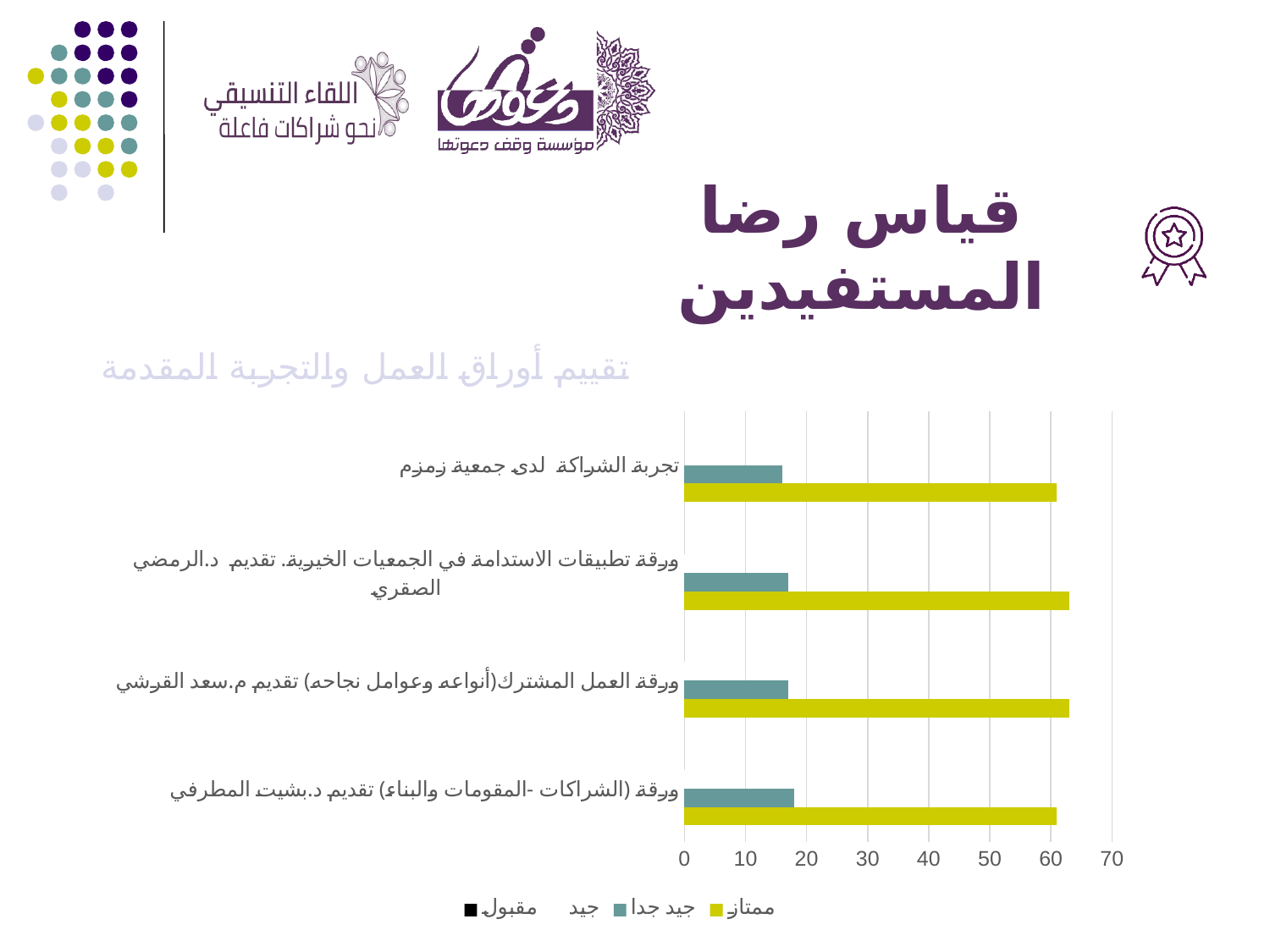
For ورقة (الشراكات - المقومات والبناء) تقديم د.بشيت المطرفي, which is larger: the ممتاز value or the جيد جدا value? ممتاز Is the ممتاز value for ورقة تطبيقات الاستدامة في الجمعيات الخيرية greater or less than 40? greater What is the highest value shown on the horizontal axis? 70 How many series does the chart legend list? 4 Is the جيد جدا value for ورقة (الشراكات - المقومات والبناء) تقديم د.بشيت المطرفي greater or less than 10? greater What kind of chart is shown on the slide? bar chart Which legend entry is shown in yellow? ممتاز For تجربة الشراكة لدى جمعية زمزم, which is larger: the جيد جدا value or the ممتاز value? ممتاز Is the ممتاز value for ورقة العمل المشترك (أنواعه وعوامل نجاحه) تقديم م.سعد القرشي greater or less than 60? greater How many categories (papers/experiences) are plotted on the chart? 4